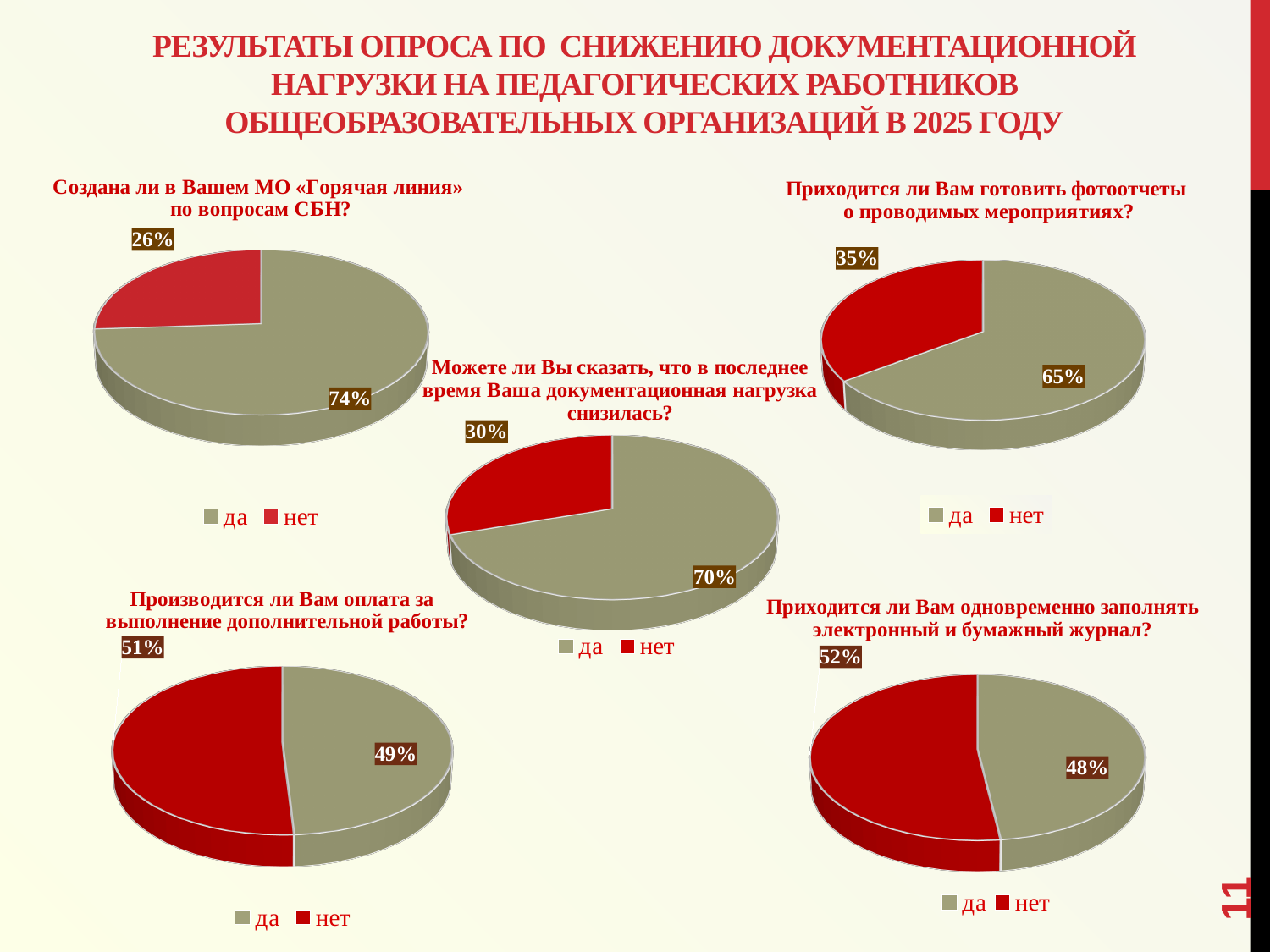
How many entries does the legend of the chart titled «Можете ли Вы сказать, что в последнее время Ваша документационная нагрузка снизилась?» list? 2 In the chart titled «Создана ли в Вашем МО «Горячая линия» по вопросам СБН?», what share of respondents answered «нет»? 26% In the chart titled «Производится ли Вам оплата за выполнение дополнительной работы?», what is the value for «да»? 49% What type of chart is used for the chart titled «Создана ли в Вашем МО «Горячая линия» по вопросам СБН?»? Pie chart In the chart titled «Можете ли Вы сказать, что в последнее время Ваша документационная нагрузка снизилась?», what is the difference between the «да» and «нет» shares? 40% In the chart titled «Приходится ли Вам одновременно заполнять электронный и бумажный журнал?», what is the value for «да»? 48% In the chart titled «Приходится ли Вам готовить фотоотчеты о проводимых мероприятиях?», which answer has the larger share, «да» or «нет»? да In the chart titled «Приходится ли Вам готовить фотоотчеты о проводимых мероприятиях?», what is the value for «нет»? 35% In the chart titled «Создана ли в Вашем МО «Горячая линия» по вопросам СБН?», what share of respondents answered «да»? 74% In the chart titled «Производится ли Вам оплата за выполнение дополнительной работы?», what is the value for «нет»? 51% In the chart titled «Приходится ли Вам одновременно заполнять электронный и бумажный журнал?», which answer has the larger share? нет In the chart titled «Можете ли Вы сказать, что в последнее время Ваша документационная нагрузка снизилась?», what is the value for «да»? 70%